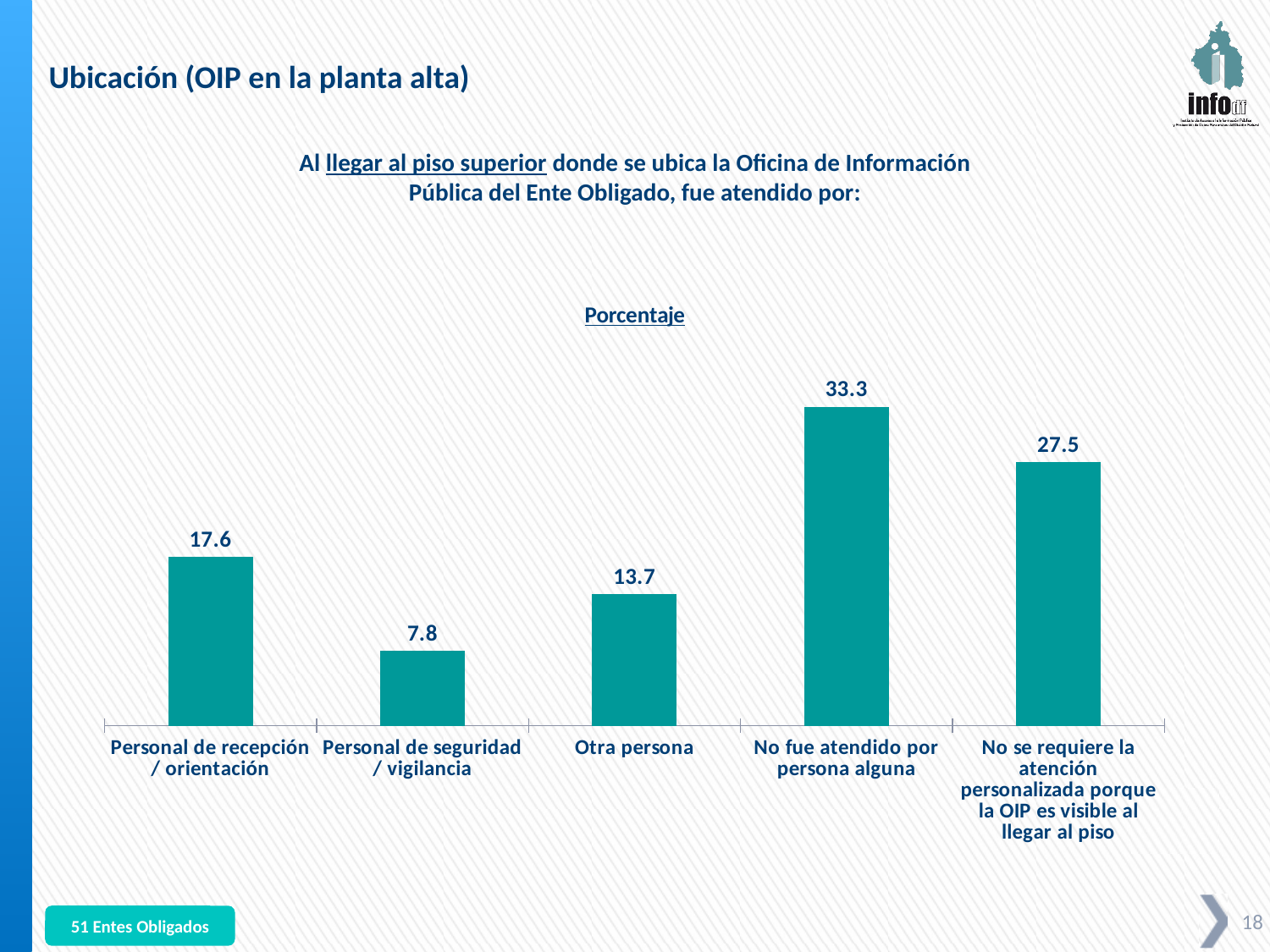
What is the value for "Otra persona"? 13.7 What is the difference between the values for "Personal de recepción / orientación" and "Personal de seguridad / vigilancia"? 9.8 How many categories are shown in the chart? 5 What is the value for "Personal de seguridad / vigilancia"? 7.8 What is the value for "Personal de recepción / orientación"? 17.6 Which is larger, the value for "Personal de recepción / orientación" or the value for "Otra persona"? Personal de recepción / orientación What is the title shown above the chart? Porcentaje Which category has the highest value? No fue atendido por persona alguna What is the value for "No fue atendido por persona alguna"? 33.3 Which category has the lowest value? Personal de seguridad / vigilancia What kind of chart is shown on the slide? Bar chart What is the difference between the values for "No fue atendido por persona alguna" and "No se requiere la atención personalizada porque la OIP es visible al llegar al piso"? 5.8